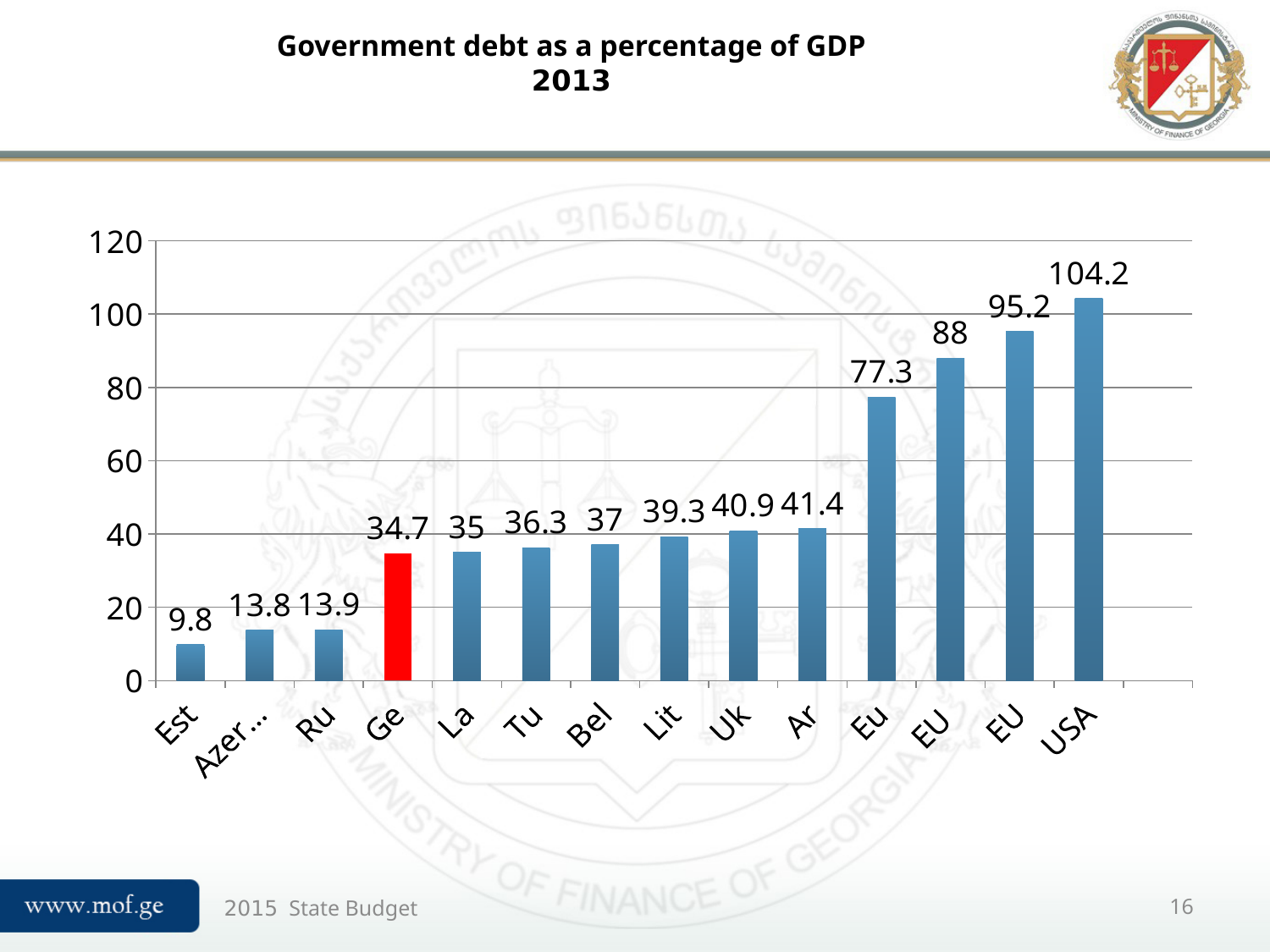
How many bars are shown in the chart? 14 Which has a larger value, Ar or Uk? Ar What type of chart is shown on the slide? bar chart What is the value shown for Lit? 39.3 Which bar is highlighted in red? Ge Which category has the highest value? USA What is the value shown for USA? 104.2 Which category has the lowest value? Est Is the value for Bel greater or less than 40? less What is the difference between the values for USA and Ge? 69.5 What is the value shown for Est? 9.8 What is the government debt as a percentage of GDP for Ge? 34.7